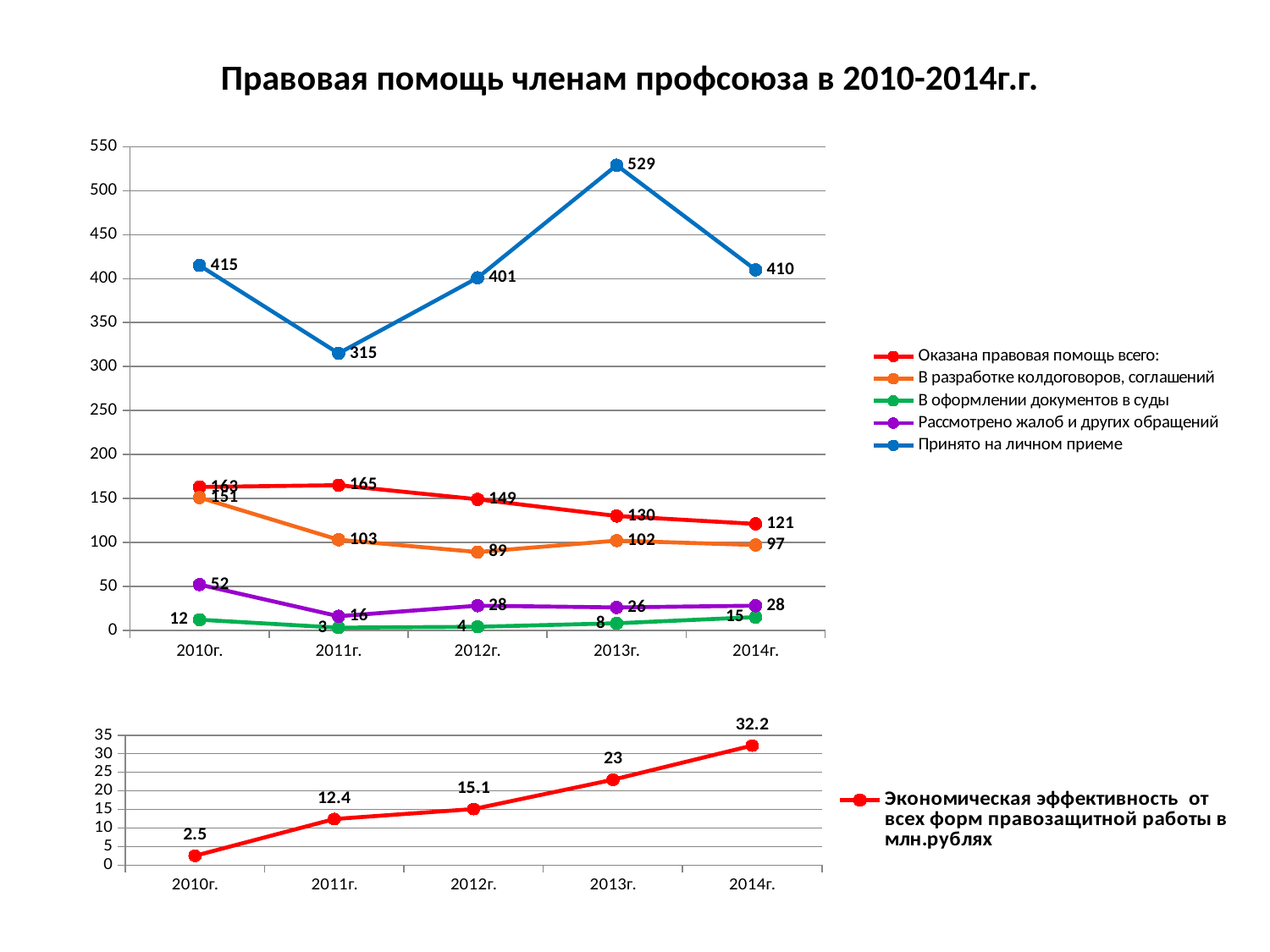
In the top chart, in which year is 'Принято на личном приеме' lowest? 2011г. In the bottom chart, what is the difference between the values for 2013г. and 2010г.? 20.5 In the top chart, what is the difference between 'Принято на личном приеме' in 2013г. and in 2014г.? 119 In the top chart, what is the value for 'В разработке колдоговоров, соглашений' in 2012г.? 89 What kind of chart is the bottom chart? Line chart In the bottom chart, what is the value for 2014г.? 32.2 In the top chart, which is larger in 2010г.: 'Рассмотрено жалоб и других обращений' or 'В оформлении документов в суды'? Рассмотрено жалоб и других обращений How many series does the legend of the top chart list? 5 In the bottom chart, do the values rise or fall from 2010г. to 2014г.? Rise In the top chart, in which year is 'Оказана правовая помощь всего:' highest? 2011г. In the top chart, what is the value for 'Оказана правовая помощь всего:' in 2014г.? 121 In the top chart, what is the value for 'Принято на личном приеме' in 2013г.? 529